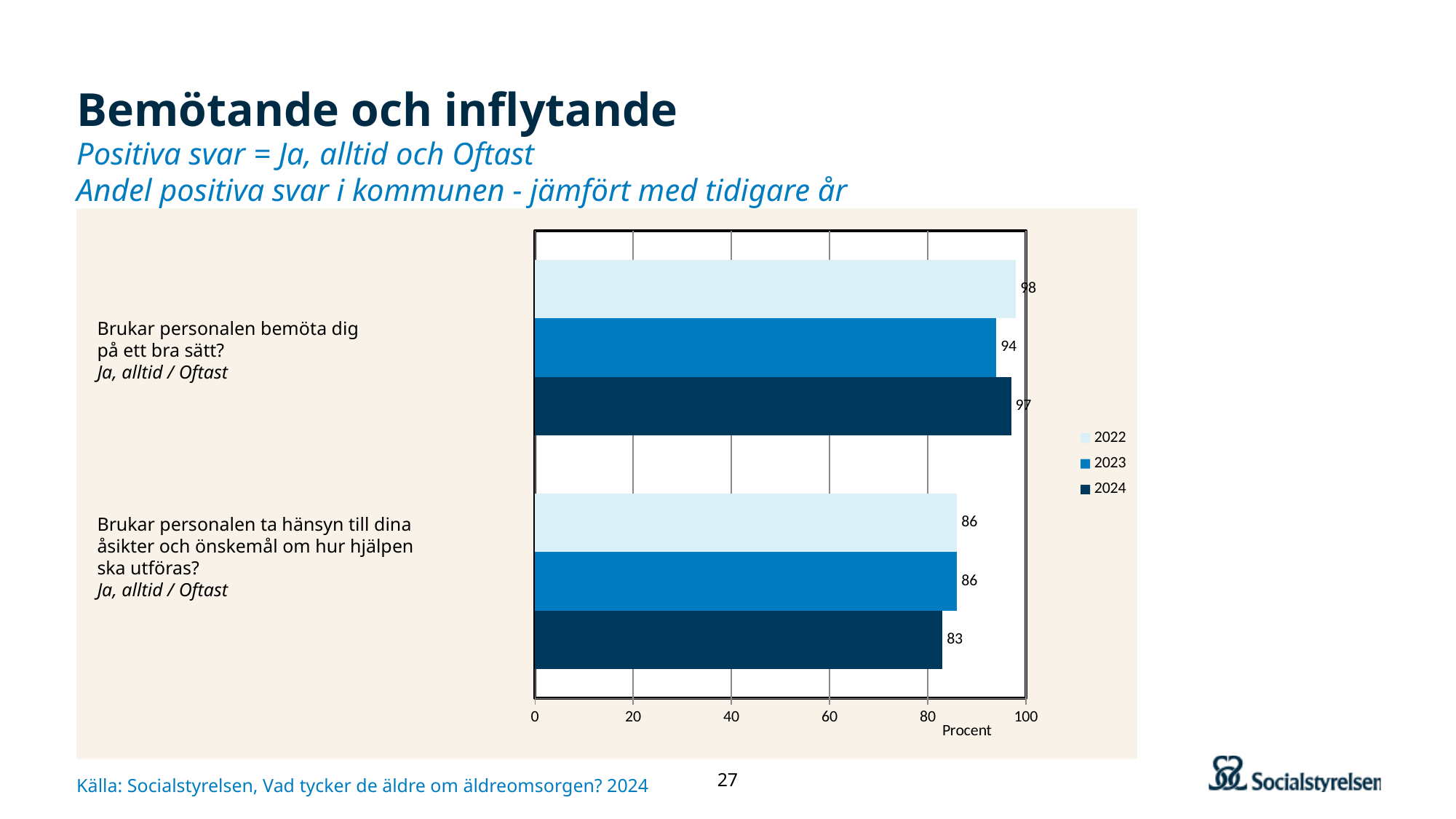
What is the difference between the 2022 and 2023 values for "Brukar personalen bemöta dig på ett bra sätt?"? 4 Which is larger: the 2024 value for "Brukar personalen bemöta dig på ett bra sätt?" or the 2024 value for "Brukar personalen ta hänsyn till dina åsikter och önskemål om hur hjälpen ska utföras?"? Brukar personalen bemöta dig på ett bra sätt? What is the difference between the 2024 values of the two questions? 14 What is the 2022 value for "Brukar personalen ta hänsyn till dina åsikter och önskemål om hur hjälpen ska utföras?"? 86 What is the 2024 value for "Brukar personalen ta hänsyn till dina åsikter och önskemål om hur hjälpen ska utföras?"? 83 Which year has the lowest value for "Brukar personalen ta hänsyn till dina åsikter och önskemål om hur hjälpen ska utföras?"? 2024 Which year has the highest value for "Brukar personalen bemöta dig på ett bra sätt?"? 2022 What kind of chart is shown on the slide? bar chart What is the 2022 value for "Brukar personalen bemöta dig på ett bra sätt?"? 98 How many series does the legend list? 3 What is the 2023 value for "Brukar personalen bemöta dig på ett bra sätt?"? 94 What is the label of the x axis? Procent